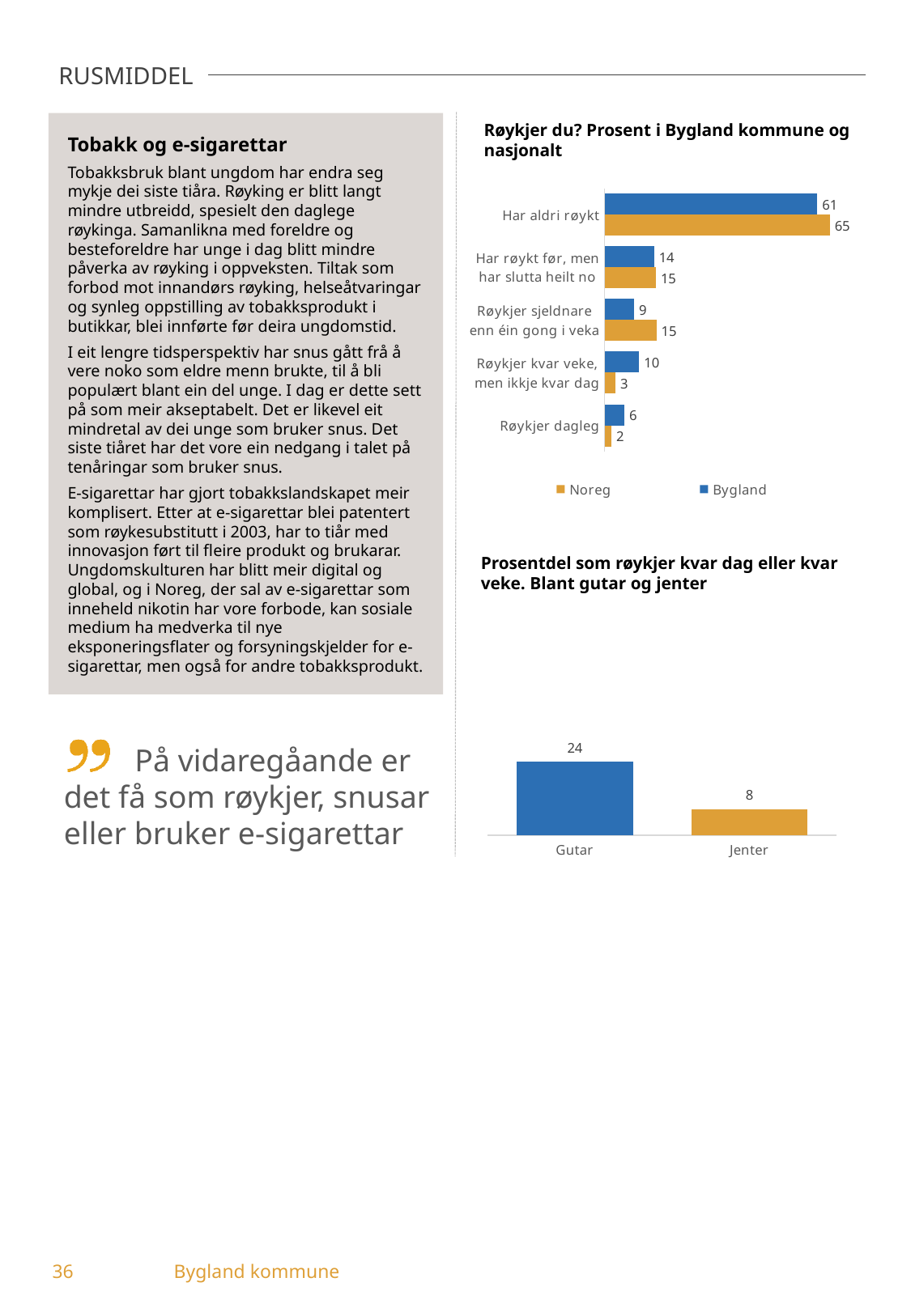
What kind of chart is 'Prosentdel som røykjer kvar dag eller kvar veke. Blant gutar og jenter'? Bar chart In the chart 'Røykjer du? Prosent i Bygland kommune og nasjonalt', which category has the lowest value for Noreg? Røykjer dagleg In the chart 'Røykjer du? Prosent i Bygland kommune og nasjonalt', what is the difference between Noreg and Bygland in the category 'Røykjer kvar veke, men ikkje kvar dag'? 7 In the chart 'Røykjer du? Prosent i Bygland kommune og nasjonalt', what is the value for Bygland in the category 'Røykjer dagleg'? 6 In the chart 'Røykjer du? Prosent i Bygland kommune og nasjonalt', what is the value for Bygland in the category 'Har aldri røykt'? 61 In the chart 'Røykjer du? Prosent i Bygland kommune og nasjonalt', what is the value for Noreg in the category 'Røykjer sjeldnare enn éin gong i veka'? 15 In the chart 'Prosentdel som røykjer kvar dag eller kvar veke. Blant gutar og jenter', what is the value for Jenter? 8 In the chart 'Røykjer du? Prosent i Bygland kommune og nasjonalt', which category has the highest value for Noreg? Har aldri røykt How many series does the legend list in the chart 'Røykjer du? Prosent i Bygland kommune og nasjonalt'? 2 In the chart 'Røykjer du? Prosent i Bygland kommune og nasjonalt', which is larger in the category 'Røykjer sjeldnare enn éin gong i veka', Noreg or Bygland? Noreg How many categories are shown in the chart 'Røykjer du? Prosent i Bygland kommune og nasjonalt'? 5 In the chart 'Prosentdel som røykjer kvar dag eller kvar veke. Blant gutar og jenter', what is the difference between Gutar and Jenter? 16